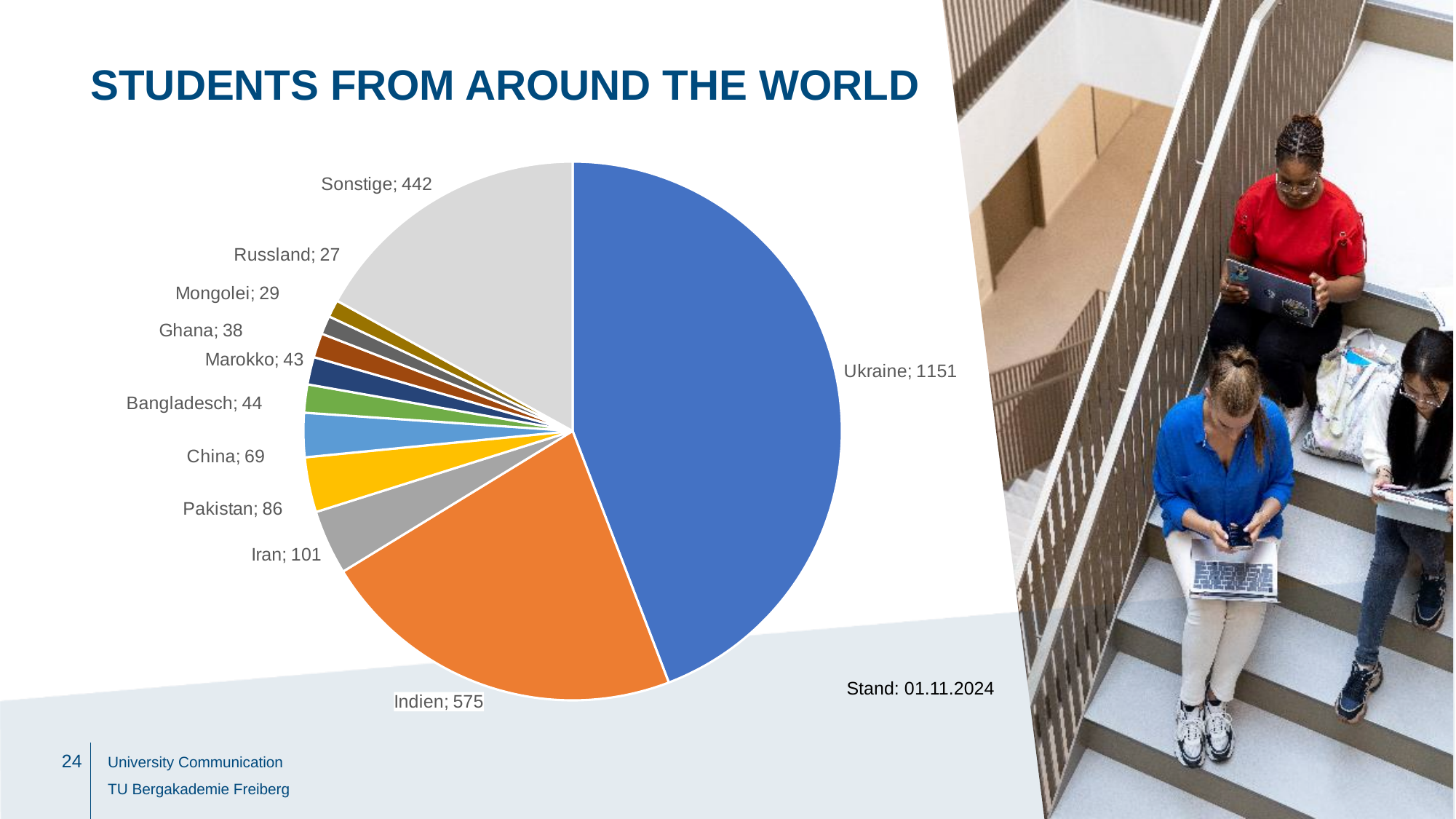
What kind of chart is shown on the slide? pie chart What is the difference between the values for Ukraine and Indien? 576 What is the value shown for Iran? 101 Which country has the largest slice of the pie? Ukraine What date is given as the 'Stand' (as-of date) for the chart data? 01.11.2024 How many students are from Ukraine according to the chart? 1151 What is the difference between the values for Marokko and Ghana? 5 Which labelled category has the smallest value? Russland How many slices does the pie chart have? 11 What is the value shown for Sonstige? 442 Which is larger, the value for Pakistan or the value for China? Pakistan What is the value shown for Indien? 575